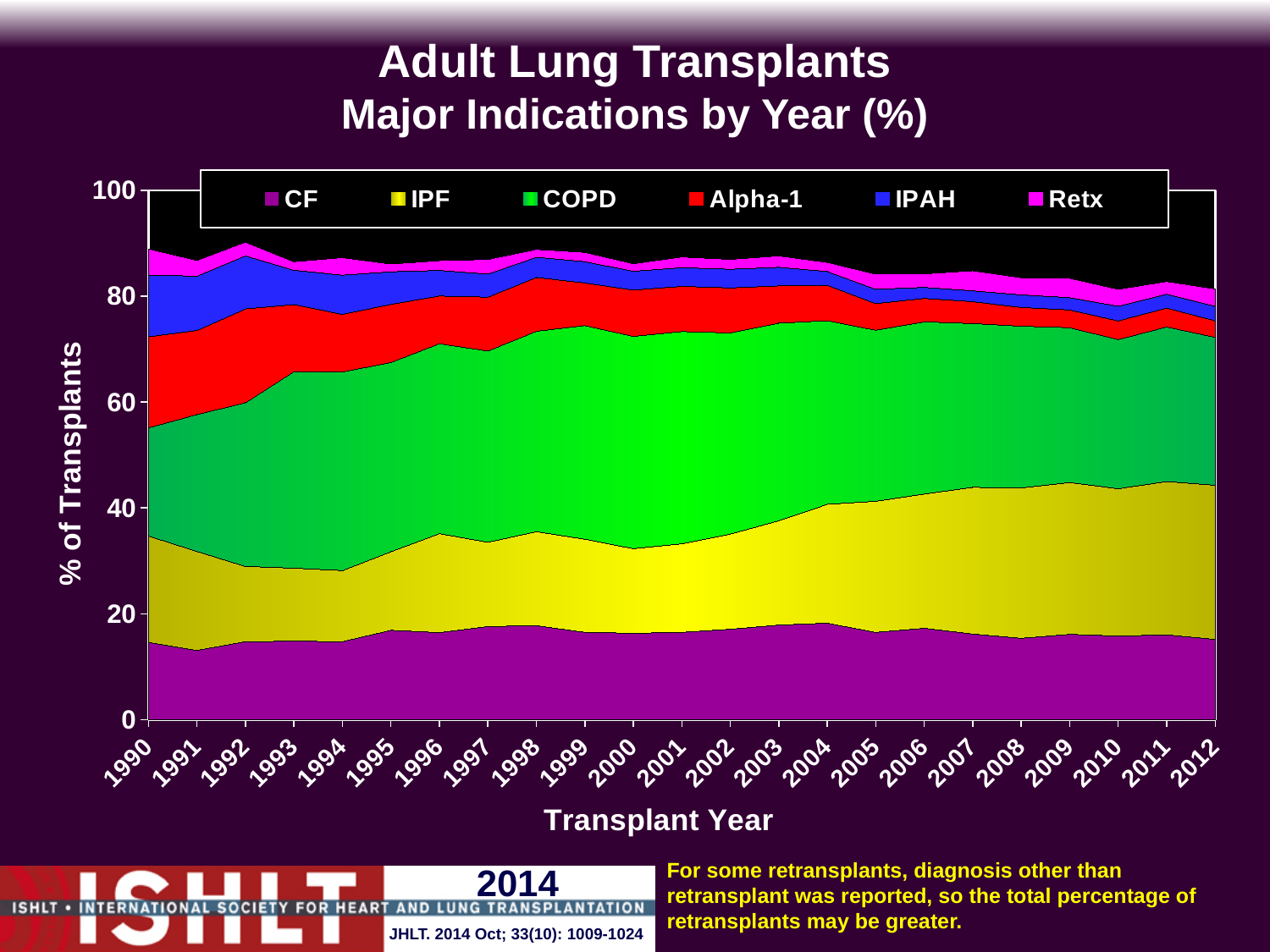
Is the top of the IPF area (CF plus IPF) in 2012 greater or less than 40? greater What kind of chart is shown on the slide? Stacked area chart Is the top of the IPF area (CF plus IPF) higher in 1990 or in 2012? 2012 Is the top of the CF area in 1990 greater or less than 20? less Is the top of the COPD area in 2004 greater or less than 60? greater What is the title of the chart? Adult Lung Transplants Major Indications by Year (%) How many series does the legend list? 6 Does the upper boundary of the IPF area rise or fall from 1990 to 2012? rises What is the label of the y axis? % of Transplants How many transplant years are plotted along the x axis? 23